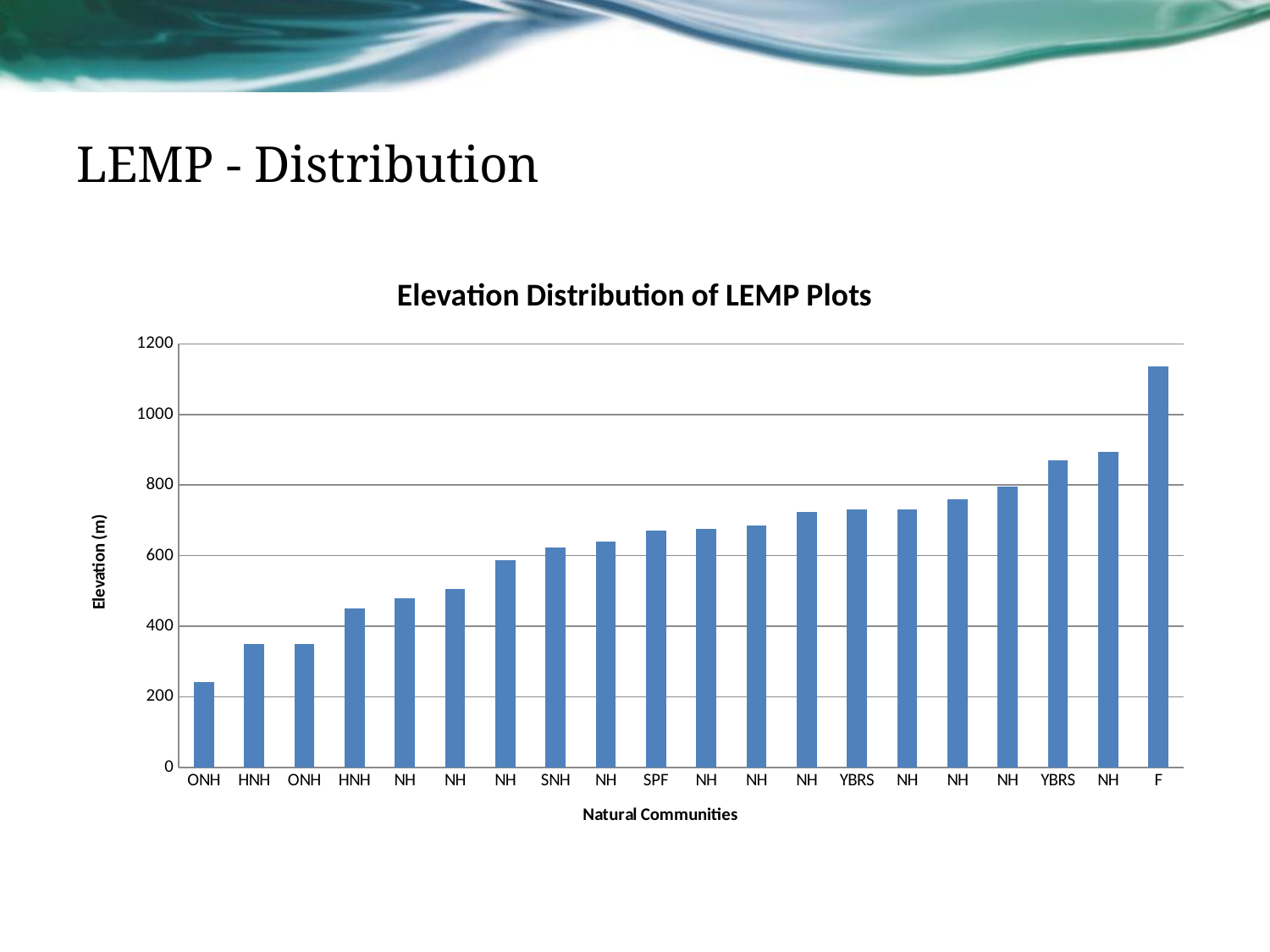
Which natural community has the highest elevation in the chart? F What is the title of the chart? Elevation Distribution of LEMP Plots What is the label on the vertical axis of the chart? Elevation (m) Is the elevation for SNH greater or less than 800? less Is the elevation of the leftmost ONH bar greater or less than 400? less What kind of chart is shown on the slide? bar chart How many bars are plotted in the chart? 20 Is the elevation for SPF greater or less than 600? greater Do the bar heights rise or fall from left to right across the chart? rise Which has a higher elevation, SPF or SNH? SPF Which bar is the lowest in the chart? the leftmost ONH bar